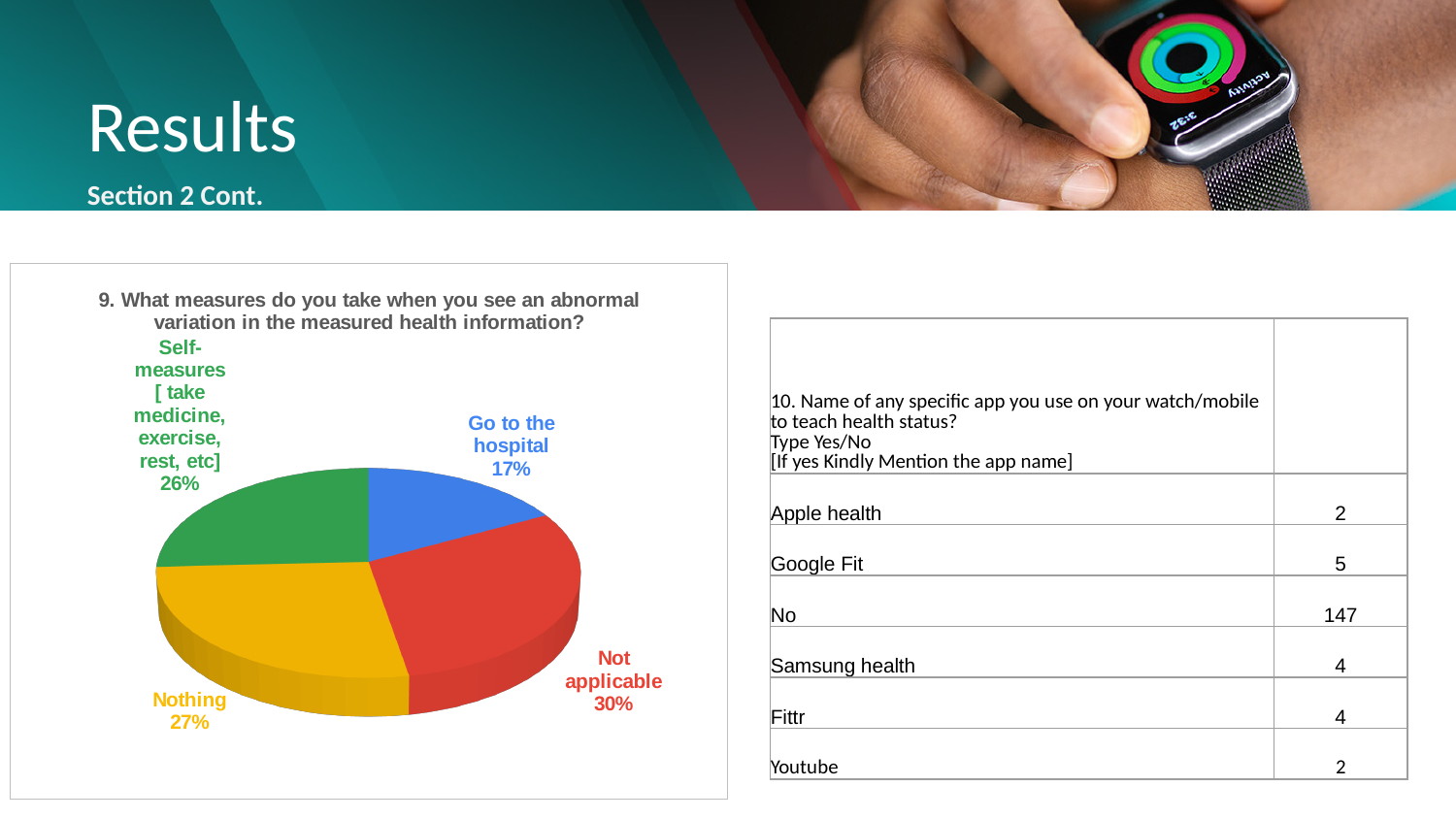
What is the title of the pie chart? 9. What measures do you take when you see an abnormal variation in the measured health information? What share of the pie chart is 'Go to the hospital'? 17% What colour is the 'Nothing' slice in the pie chart? Yellow What share of the pie chart is 'Self-measures [take medicine, exercise, rest, etc]'? 26% What type of chart is shown on the slide? Pie chart How many slices does the pie chart have? 4 Which slice of the pie chart is the largest? Not applicable What is the difference in percentage points between 'Not applicable' and 'Go to the hospital' in the pie chart? 13 Which slice of the pie chart is the smallest? Go to the hospital Which is larger in the pie chart, 'Nothing' or 'Self-measures'? Nothing What share of the pie chart is 'Nothing'? 27%